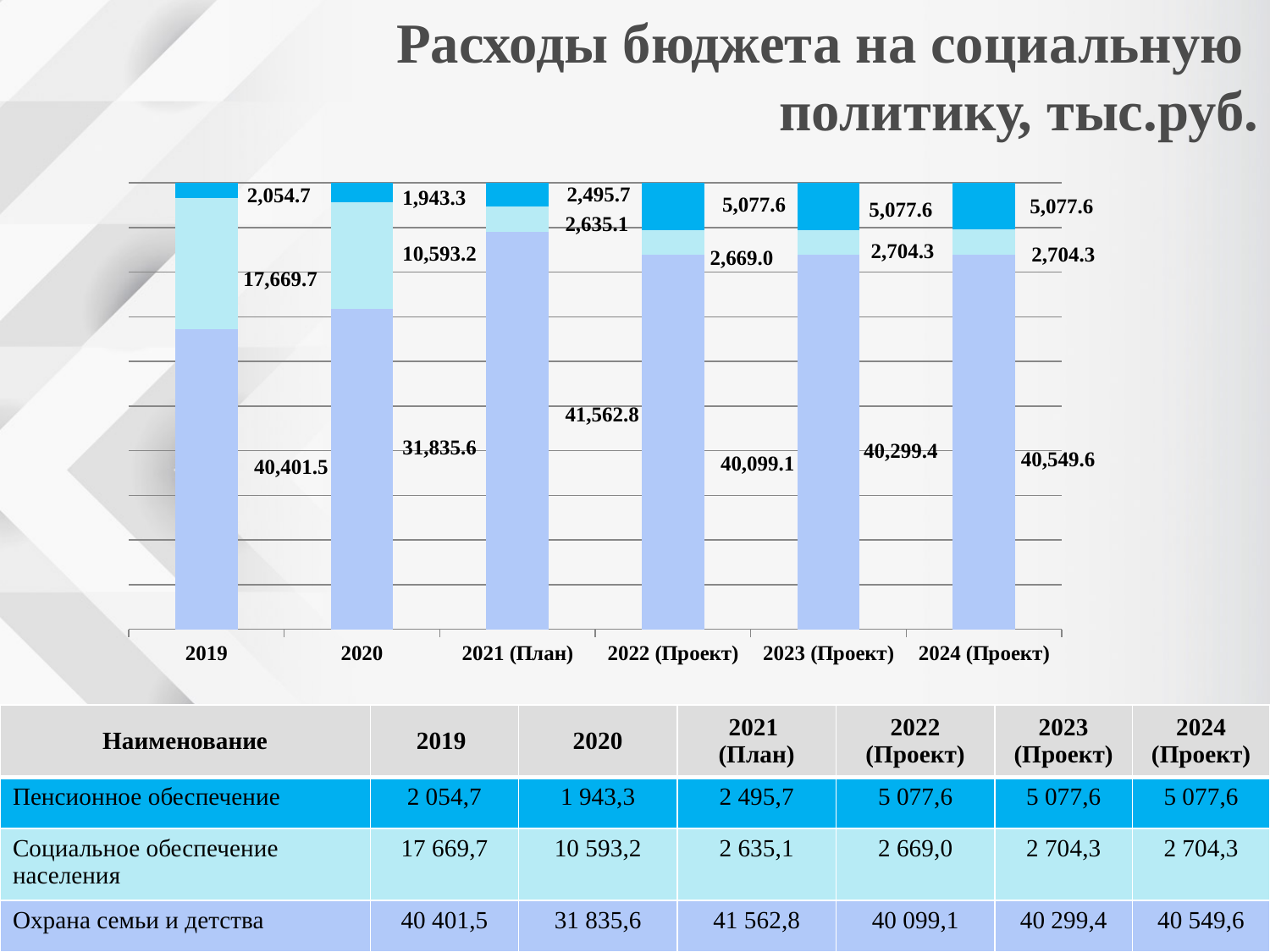
In which year is the bottom segment (Охрана семьи и детства) the smallest? 2020 What kind of chart is shown on the slide? stacked bar chart How many year categories are shown along the x axis of the chart? 6 What is the difference between the Охрана семьи и детства values for 2021 (План) and 2020? 9,727.2 What is the total of the stacked bar for 2019? 60,125.9 What is the value of the bottom segment (Охрана семьи и детства) for 2019? 40,401.5 Which is larger: the Социальное обеспечение населения value for 2019 or for 2020? 2019 What is the title of the chart on the slide? Расходы бюджета на социальную политику, тыс.руб. In which year is the bottom segment (Охрана семьи и детства) the largest? 2021 (План) What is the value of the top segment (Пенсионное обеспечение) for 2021 (План)? 2,495.7 How many segments (series) are stacked in each bar of the chart? 3 What is the value of the middle segment (Социальное обеспечение населения) for 2023 (Проект)? 2,704.3